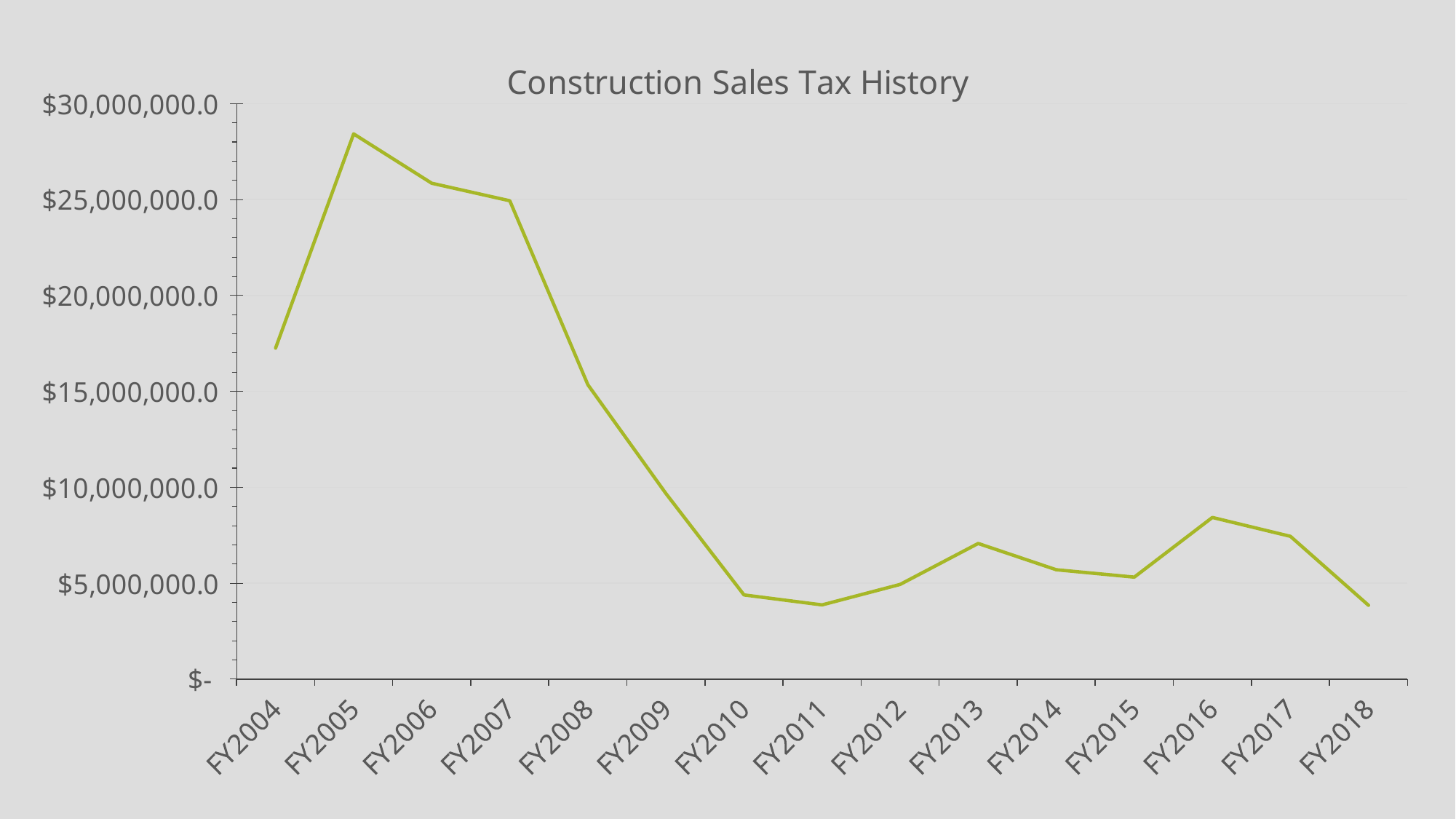
Is the value for FY2004 greater or less than $15,000,000.0? greater Which fiscal year has the highest construction sales tax value? FY2005 Overall, do the values rise or fall from FY2004 to FY2018? Fall Is the value for FY2013 greater or less than $10,000,000.0? less Which is larger, the value for FY2008 or the value for FY2009? FY2008 What is the title of the chart? Construction Sales Tax History Is the value for FY2005 greater or less than $25,000,000.0? greater Which is larger, the value for FY2016 or the value for FY2015? FY2016 How many fiscal years are plotted on the x axis? 15 What kind of chart is shown on the slide? Line chart